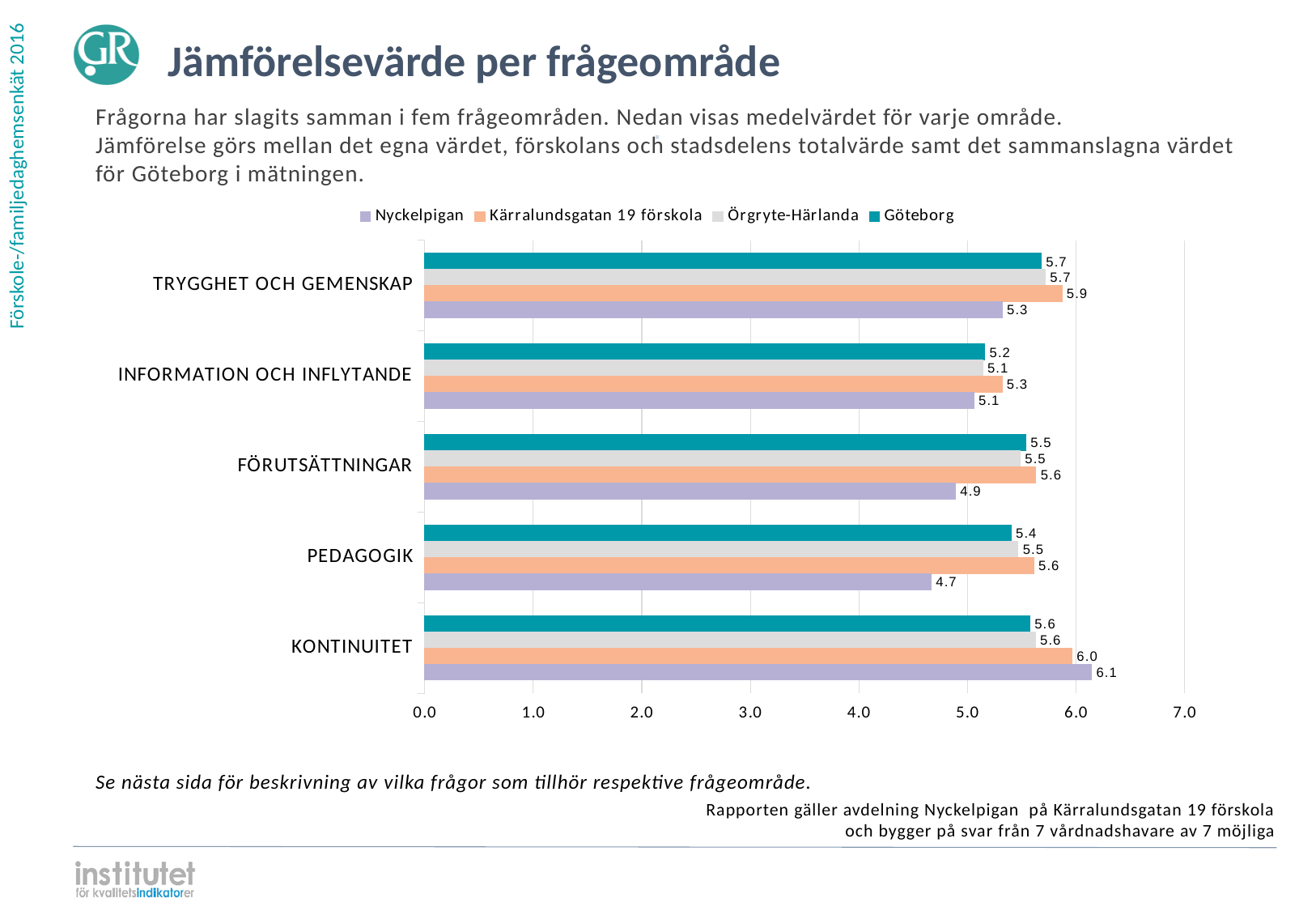
What is the value for Nyckelpigan in the KONTINUITET category? 6.1 In which category does Nyckelpigan have its lowest value? PEDAGOGIK How many series does the legend list? 4 In which category does Nyckelpigan have its highest value? KONTINUITET What is the difference between the Kärralundsgatan 19 förskola value and the Nyckelpigan value in the FÖRUTSÄTTNINGAR category? 0.7 What is the value for Kärralundsgatan 19 förskola in the TRYGGHET OCH GEMENSKAP category? 5.9 What is the title of the slide containing the chart? Jämförelsevärde per frågeområde How many categories are shown on the chart? 5 Which is larger in the PEDAGOGIK category: the value for Nyckelpigan or the value for Örgryte-Härlanda? Örgryte-Härlanda What is the value for Göteborg in the PEDAGOGIK category? 5.4 What kind of chart is shown on the slide? Bar chart What is the value for Örgryte-Härlanda in the INFORMATION OCH INFLYTANDE category? 5.1